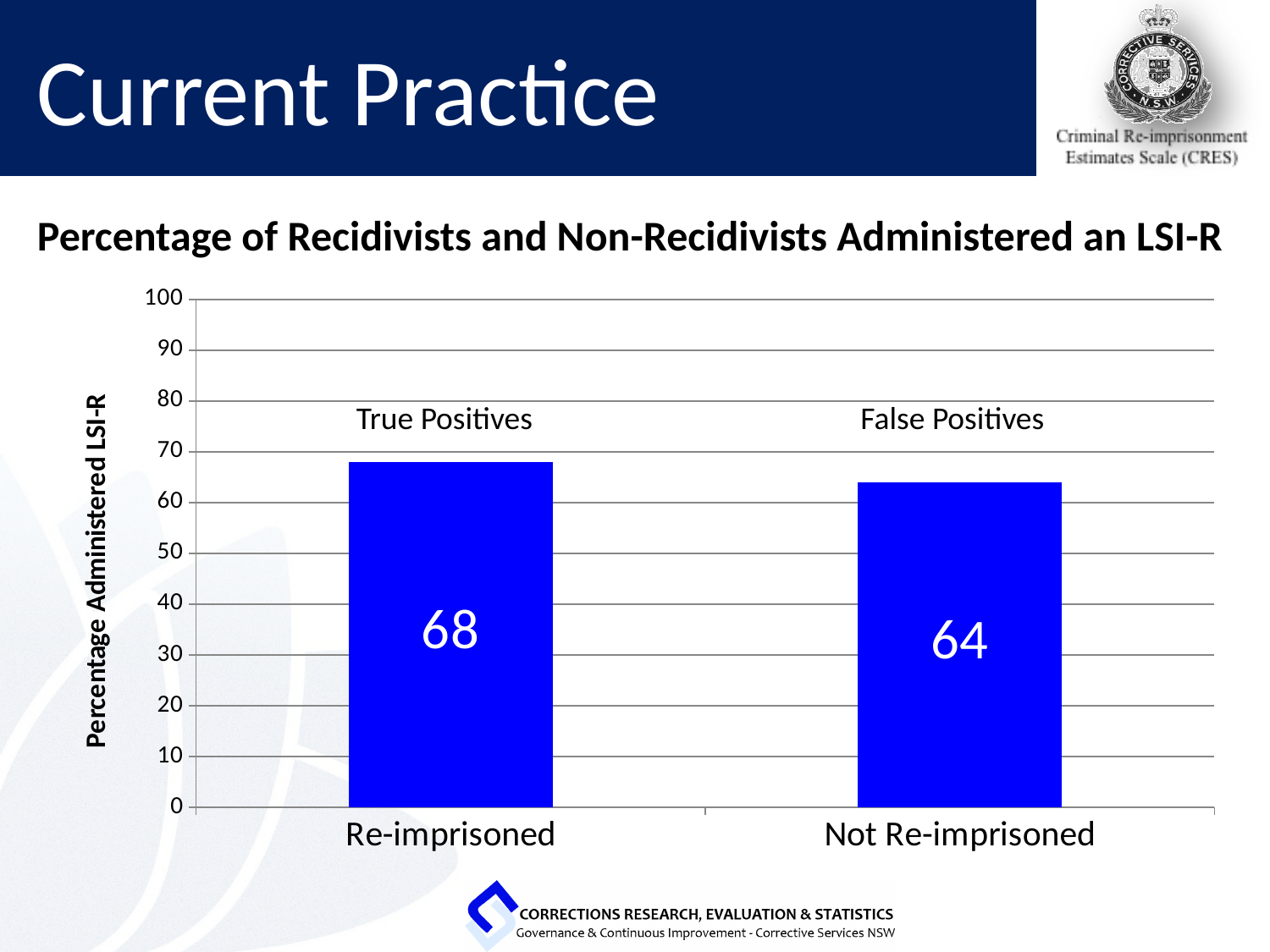
Which is larger, the value for Re-imprisoned or Not Re-imprisoned? Re-imprisoned What is the difference between the values for Re-imprisoned and Not Re-imprisoned? 4 What is the value for Not Re-imprisoned? 64 Is the value for Not Re-imprisoned greater or less than 70? less How many categories are shown on the x axis? 2 Which category has the lowest value? Not Re-imprisoned What kind of chart is shown on the slide? bar chart What is the value for Re-imprisoned? 68 Which category has the highest value? Re-imprisoned Is the value for Re-imprisoned greater or less than 60? greater What label appears above the Not Re-imprisoned bar? False Positives What is the title of the chart? Percentage of Recidivists and Non-Recidivists Administered an LSI-R